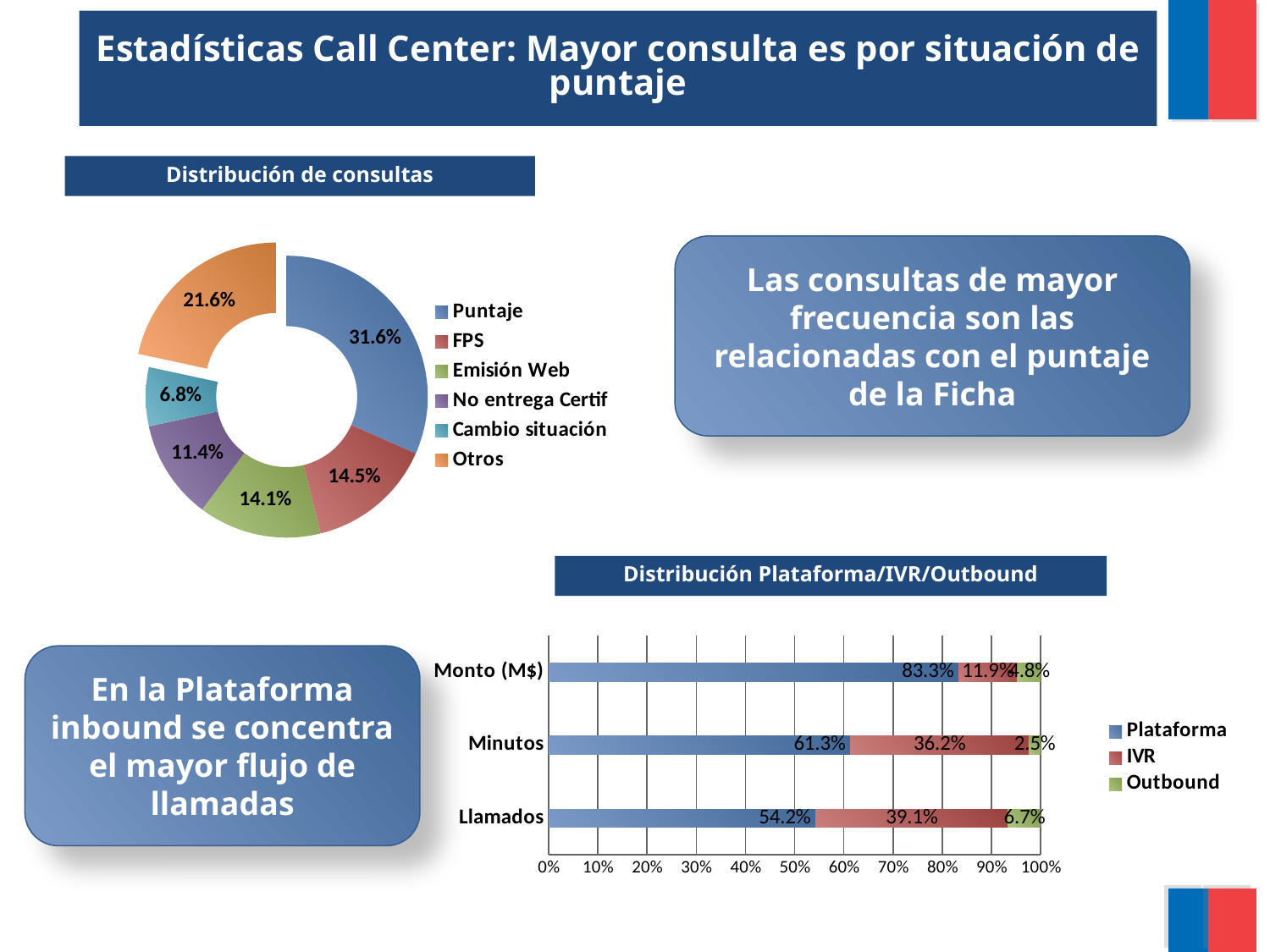
In the 'Distribución Plataforma/IVR/Outbound' chart, how many series does the legend list? 3 What kind of chart is 'Distribución de consultas'? Doughnut chart In the 'Distribución de consultas' chart, which category has the largest share? Puntaje In the 'Distribución Plataforma/IVR/Outbound' chart, which category has the highest Plataforma value? Monto (M$) In the 'Distribución Plataforma/IVR/Outbound' chart, what is the Plataforma value for Minutos? 61.3% In the 'Distribución Plataforma/IVR/Outbound' chart, what is the IVR value for Llamados? 39.1% In the 'Distribución de consultas' chart, what is the difference between the Otros share and the No entrega Certif share? 10.2% In the 'Distribución de consultas' chart, what share does Cambio situación have? 6.8% In the 'Distribución de consultas' chart, which category has the smallest share? Cambio situación In the 'Distribución de consultas' chart, how many categories does the legend list? 6 What kind of chart is 'Distribución Plataforma/IVR/Outbound'? Stacked bar chart In the 'Distribución de consultas' chart, what share of consultations is for Puntaje? 31.6%